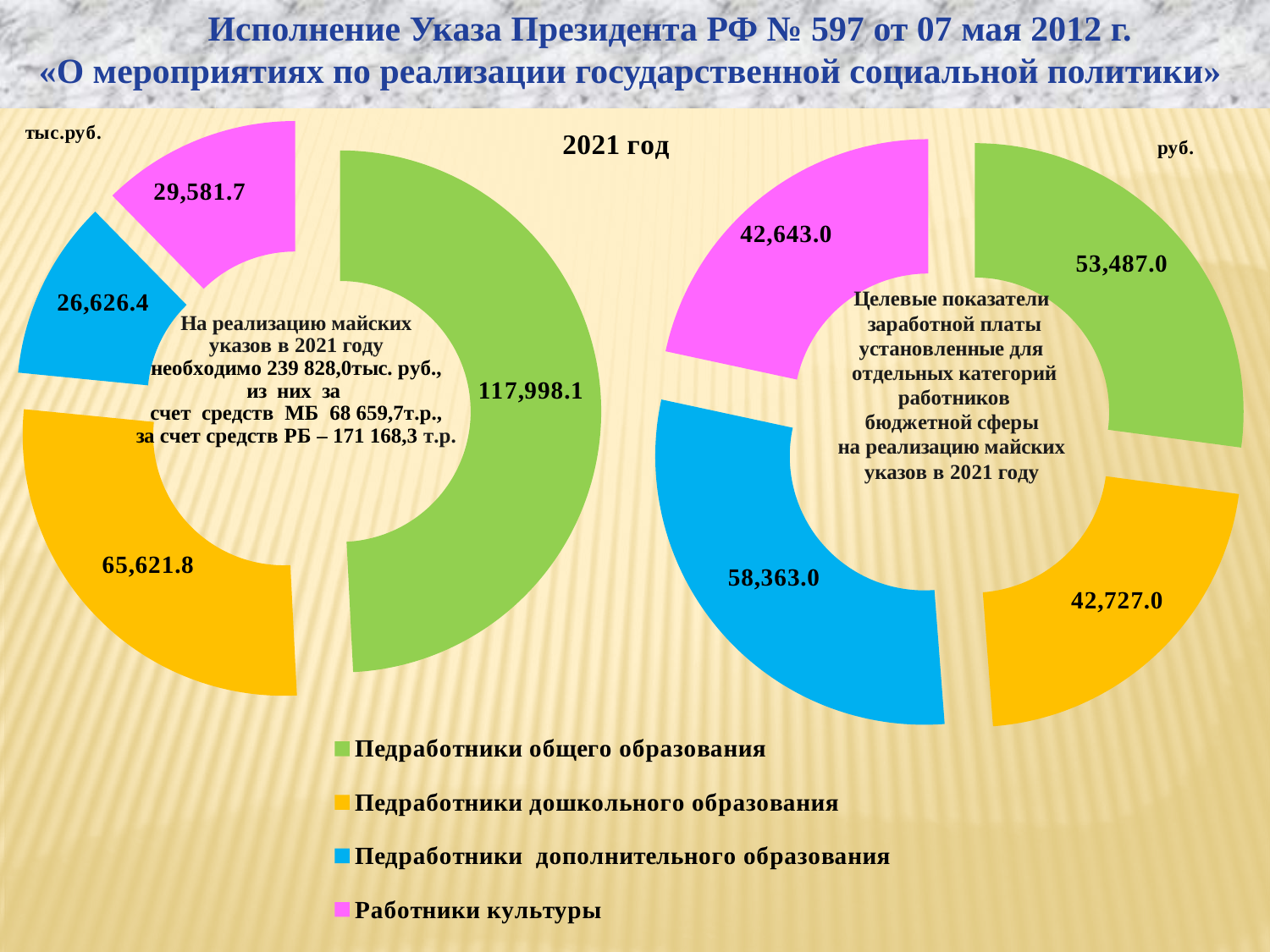
What kind of chart is used on this slide? Doughnut (pie) chart In the left chart (тыс.руб.), which category has the lowest value? Педработники дополнительного образования In the right chart (руб.), what is the difference between the values for Педработники дополнительного образования and Педработники общего образования? 4,876.0 In the left chart (тыс.руб.), what is the value for Работники культуры? 29,581.7 In the left chart (тыс.руб.), which is larger: the value for Работники культуры or the value for Педработники дополнительного образования? Работники культуры In the left chart (тыс.руб.), which category has the highest value? Педработники общего образования In the right chart (руб.), what is the value for Педработники дополнительного образования? 58,363.0 In the left chart (тыс.руб.), what is the value for Педработники общего образования? 117,998.1 In the right chart (руб.), which category has the highest value? Педработники дополнительного образования How many categories does the legend list? 4 In the right chart (руб.), what is the value for Педработники дошкольного образования? 42,727.0 In the left chart (тыс.руб.), what is the difference between the values for Педработники общего образования and Педработники дошкольного образования? 52,376.3